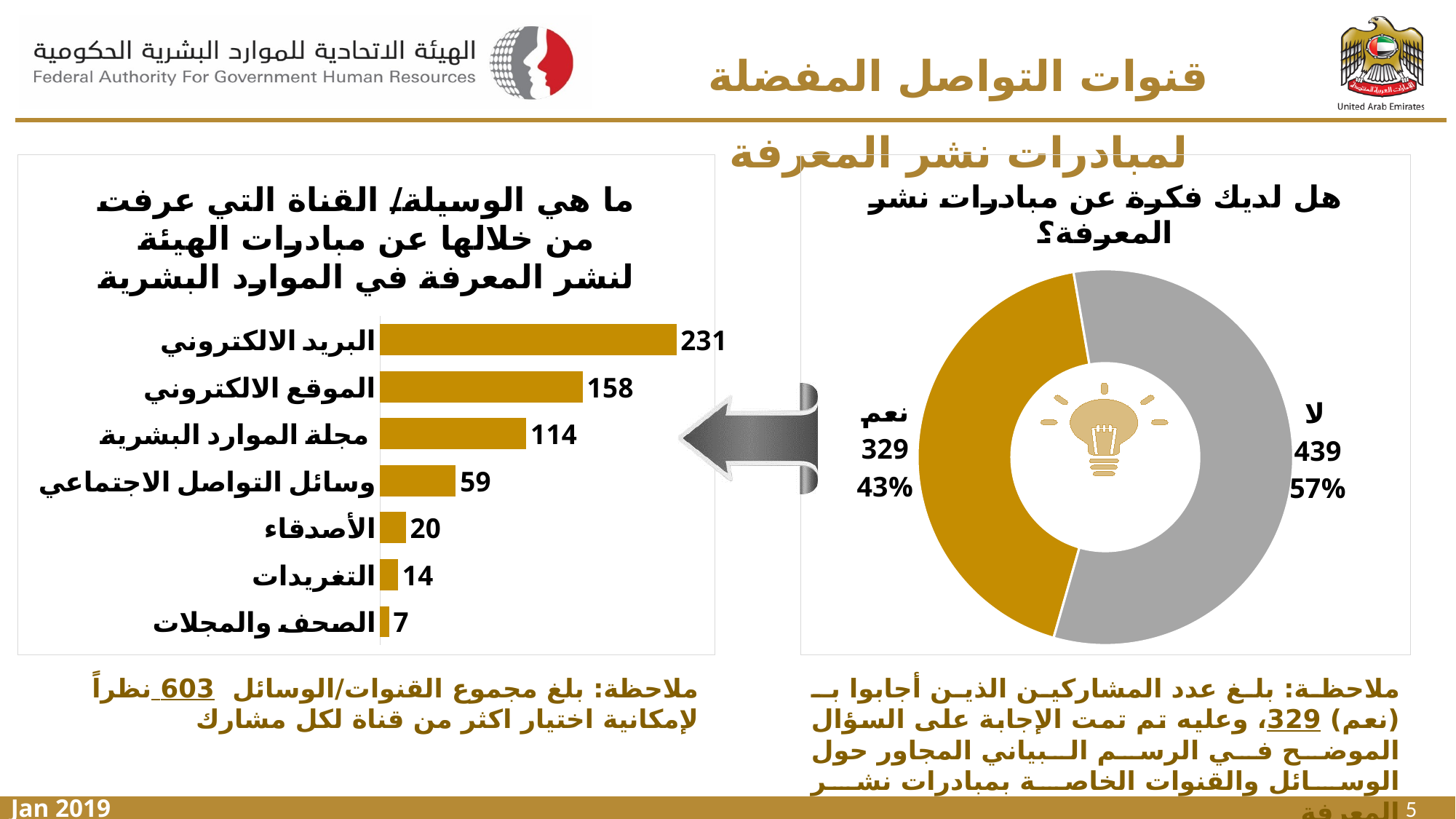
In the bar chart on the left, what is the value for البريد الالكتروني? 231 In the bar chart on the left, which category has the highest value? البريد الالكتروني In the donut chart on the right, what is the difference between the values for لا and نعم? 110 What kind of chart is shown on the left side of the slide? Bar chart How many categories are shown in the bar chart on the left? 7 In the bar chart on the left, what is the value for مجلة الموارد البشرية? 114 In the bar chart on the left, which category has the lowest value? الصحف والمجلات In the donut chart on the right, what percentage share does لا have? 57% In the bar chart on the left, what is the difference between the values for البريد الالكتروني and الموقع الالكتروني? 73 In the bar chart on the left, which is larger: وسائل التواصل الاجتماعي or الأصدقاء? وسائل التواصل الاجتماعي In the donut chart on the right, what is the value for نعم? 329 What kind of chart is shown on the right side of the slide? Donut (pie) chart